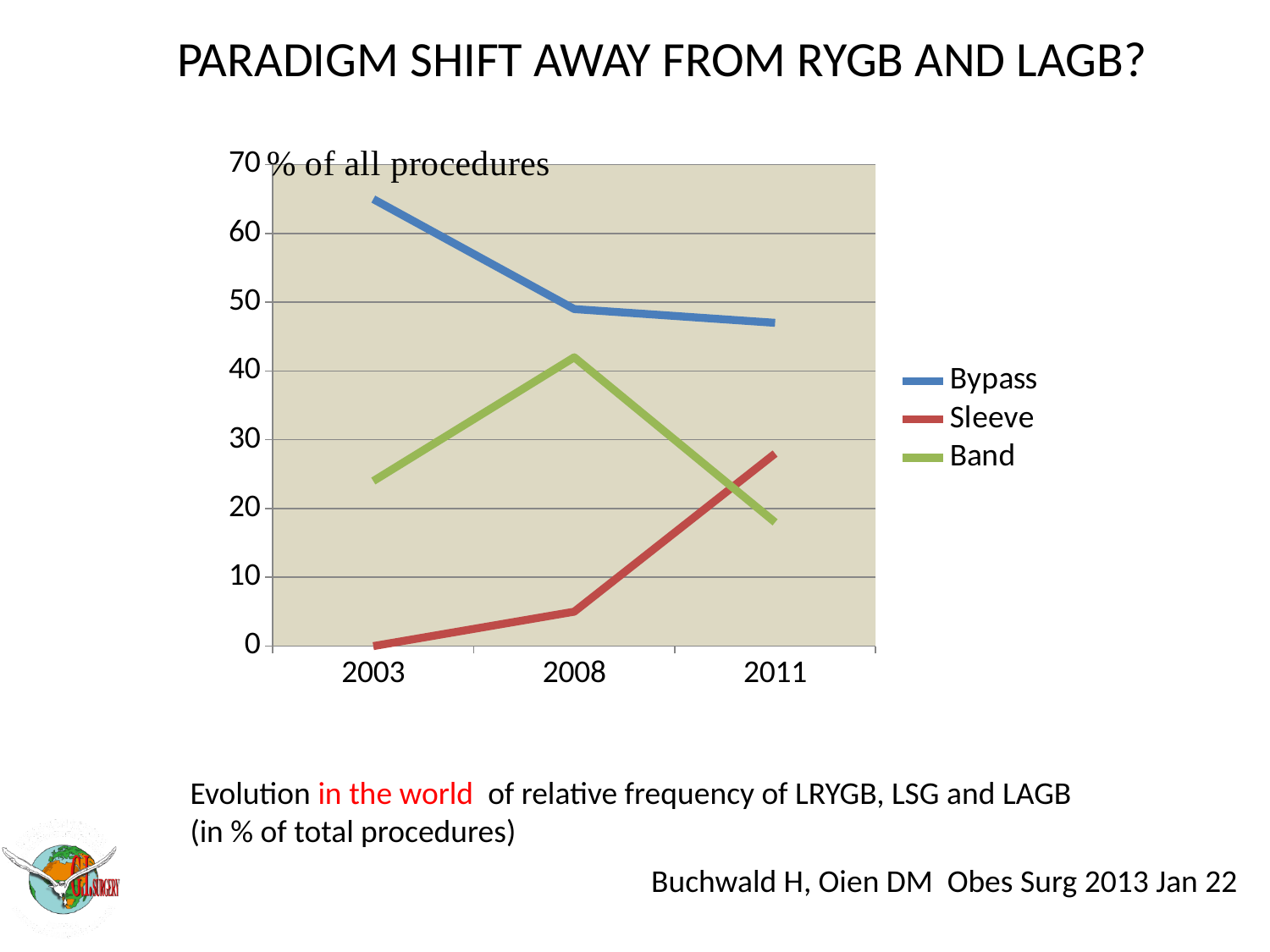
In 2008, which is larger, the value for Band or the value for Sleeve? Band Is the value for Bypass in 2003 greater or less than 60? greater Which series has the lowest value in 2011? Band Is the value for Band in 2011 greater or less than 20? less Does the Sleeve line rise or fall from 2003 to 2011? rise What kind of chart is shown on the slide? line chart What label is shown on the y axis of the chart? % of all procedures How many years are shown on the x axis? 3 Is the value for Bypass in 2011 greater or less than 50? less Which series has the highest value in 2003? Bypass How many series does the legend list? 3 What is the value for Sleeve in 2003? 0